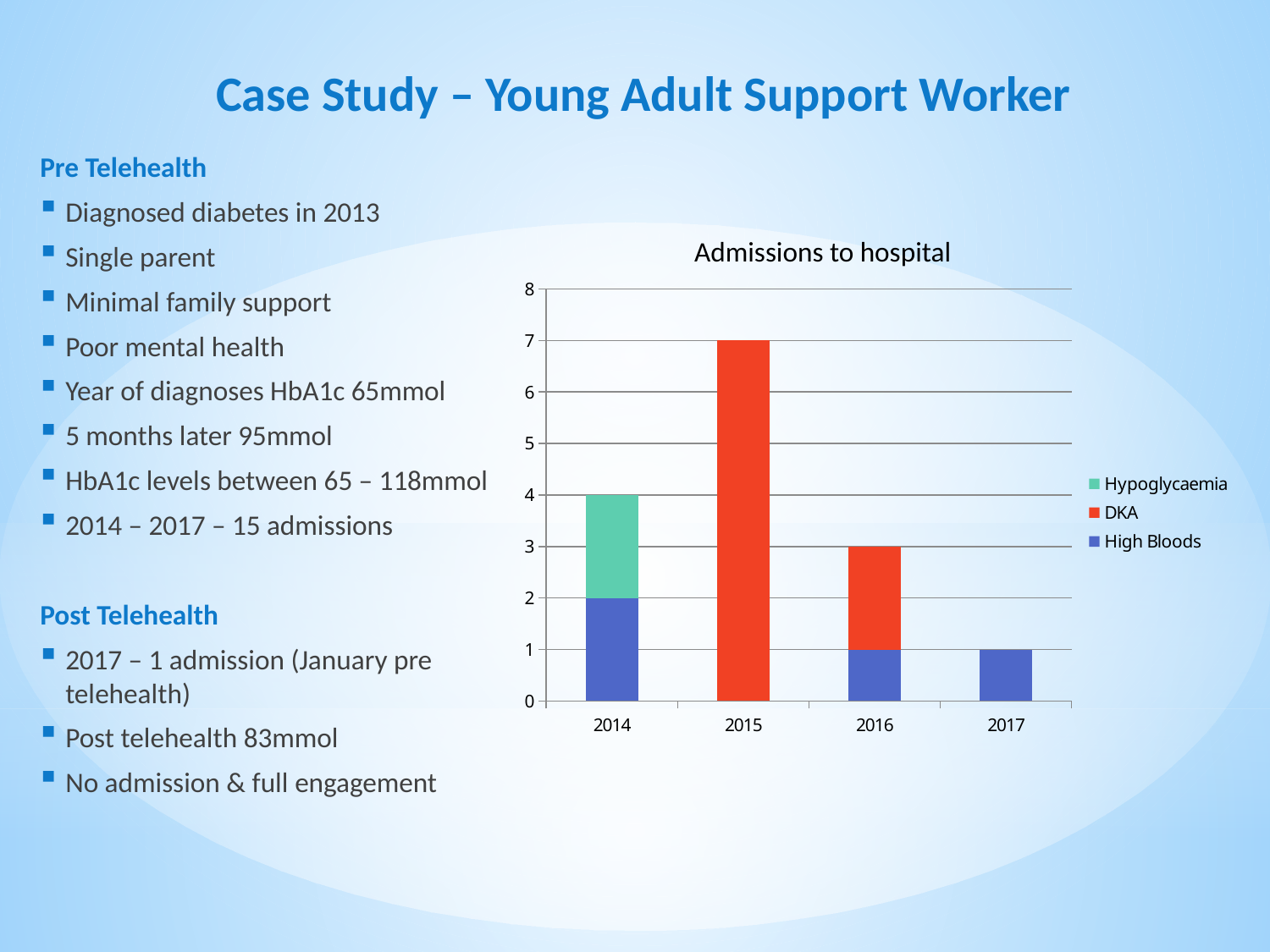
Which year has the highest total admissions in the chart? 2015 Which series is shown in red in the chart? DKA What is the value for High Bloods in 2017? 1 Which year has the lowest total admissions in the chart? 2017 How many series does the chart legend list? 3 What is the title of the chart? Admissions to hospital What kind of chart is shown on the slide? Stacked bar chart What is the total height of the stacked bar for 2016? 3 What is the value for High Bloods in 2014? 2 What is the total height of the stacked bar for 2014? 4 How many years are shown on the x axis of the chart? 4 What is the total height of the stacked bar for 2015? 7